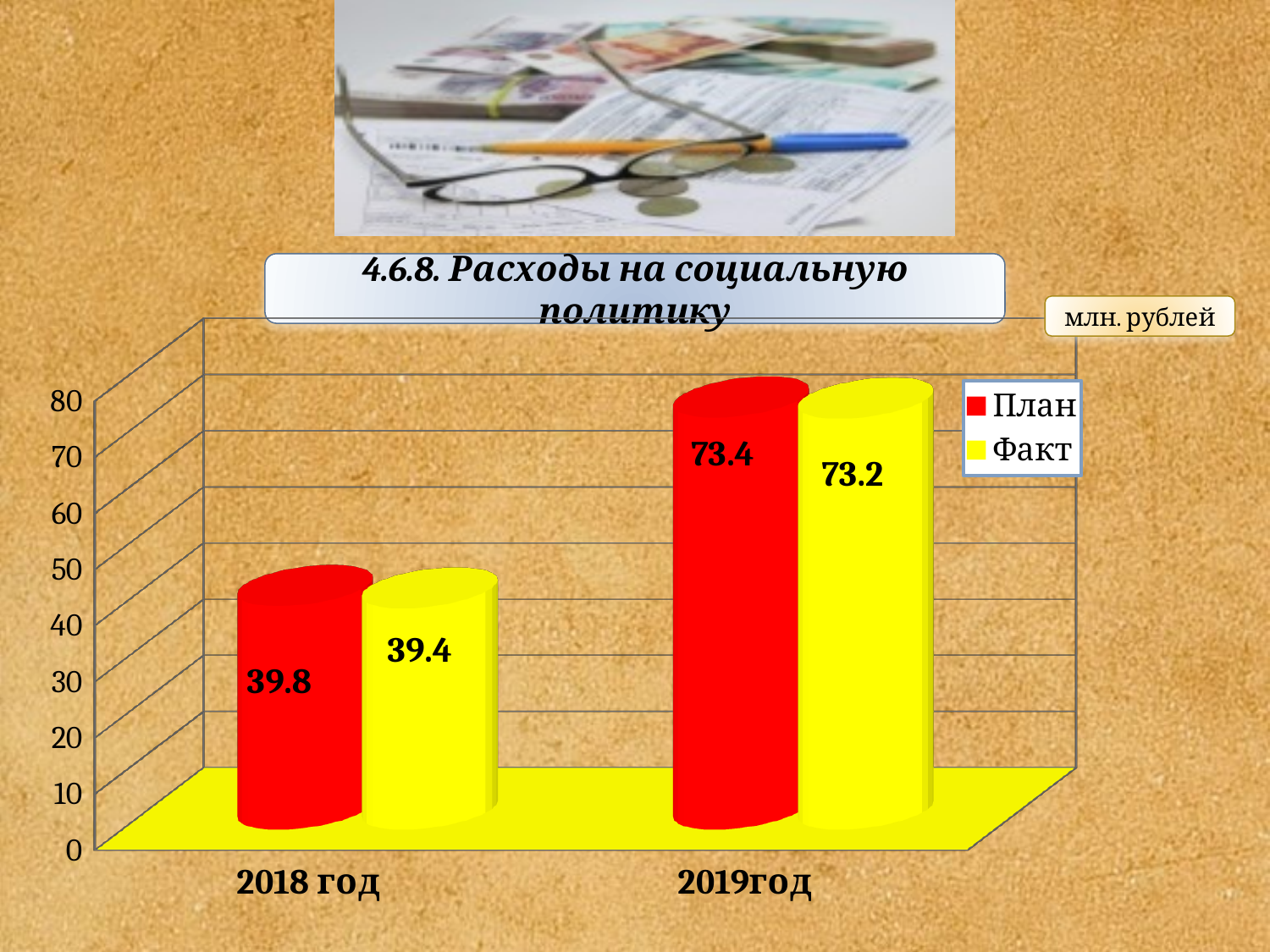
What is the Факт value for 2019год? 73.2 What colour represents the Факт series? yellow What is the difference between the План values for 2019год and 2018 год? 33.6 What kind of chart is shown on the slide? bar chart What is the План value for 2019год? 73.4 Which year has the lowest Факт value? 2018 год Which is larger, the Факт value for 2019год or the Факт value for 2018 год? 2019год What is the Факт value for 2018 год? 39.4 What is the difference between План and Факт for 2018 год? 0.4 What is the План value for 2018 год? 39.8 Which year has the highest План value? 2019год How many series does the legend list? 2